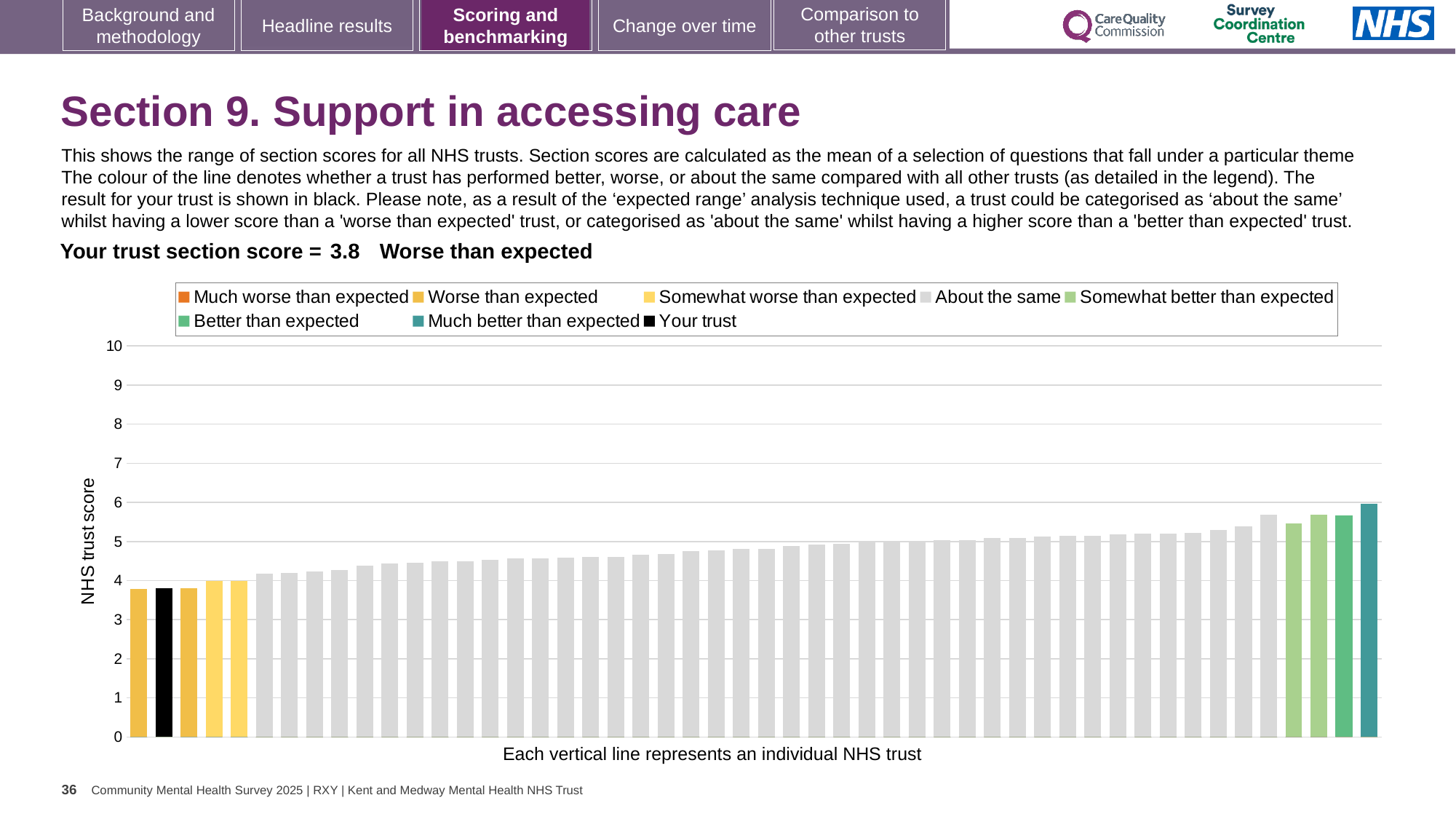
Is the black 'Your trust' bar higher or lower than the rightmost bar? Lower How many black 'Your trust' bars are shown on the chart? 1 Is the value of the tallest bar greater or less than 5? greater What is the highest value shown on the vertical axis? 10 Do the bar values rise or fall from left to right along the x axis? Rise What kind of chart is shown on the slide? Bar chart Which legend category does the tallest bar on the chart belong to? Much better than expected Is the value of the black 'Your trust' bar greater or less than 4? less What is the label on the vertical axis of the chart? NHS trust score What is the section score for your trust shown on the slide? 3.8 How many entries does the chart legend list? 8 Which performance category is your trust placed in for this section? Worse than expected